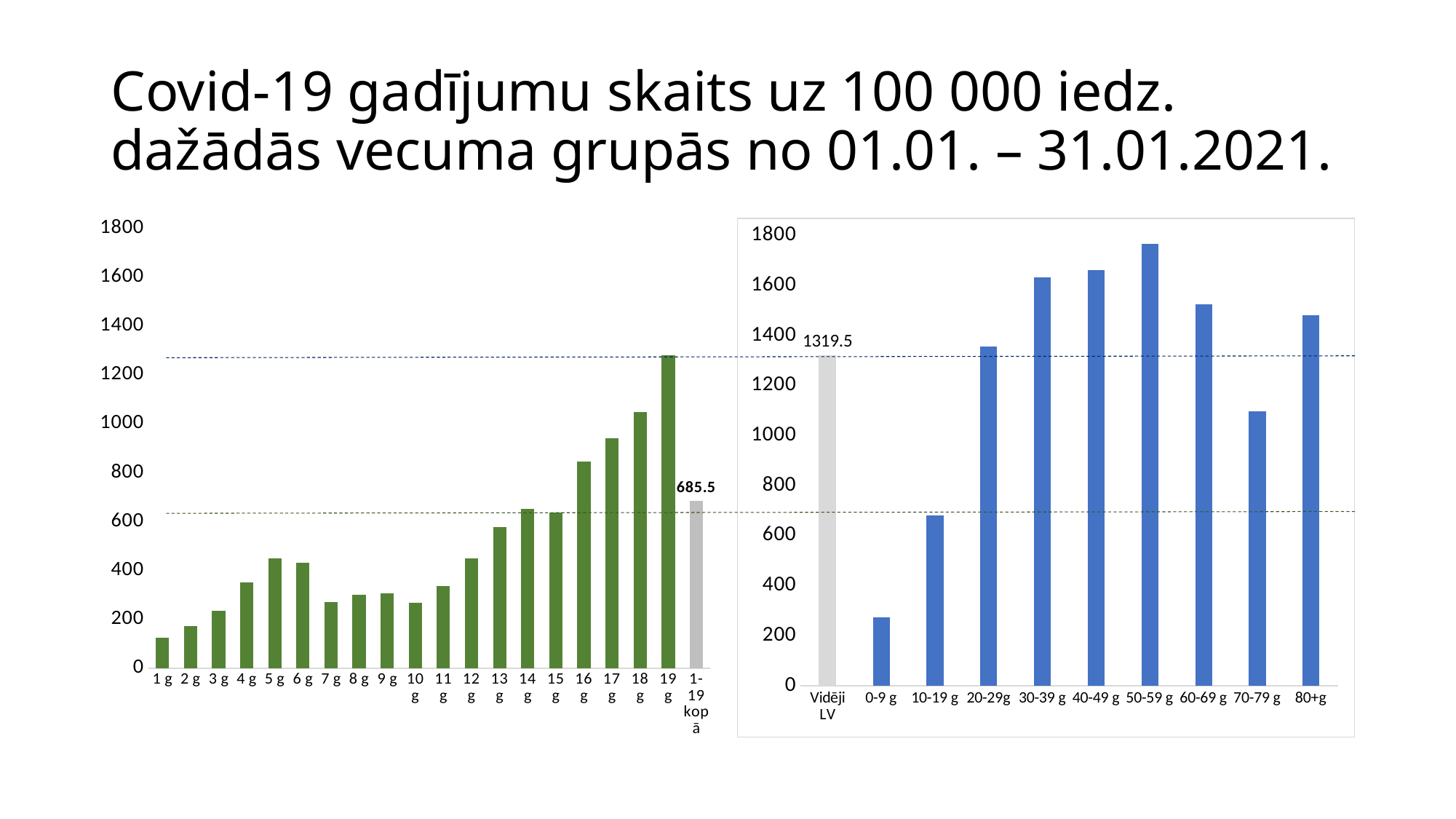
What kind of chart is the left chart? bar chart How many bars are plotted on the left chart? 20 On the left chart, which age category has the highest value? 19 g What is the difference between the "Vidēji LV" value on the right chart and the "1-19 kopā" value on the left chart? 634 On the left chart, which age category has the lowest value? 1 g On the right chart, is the value for 70-79 g greater or less than 1200? less How many bars are plotted on the right chart? 10 On the left chart, which is larger, the value for 16 g or the value for 17 g? 17 g On the left chart, what is the value shown for the "1-19 kopā" bar? 685.5 On the right chart, which age group has the highest value? 50-59 g On the right chart, what is the value shown for "Vidēji LV"? 1319.5 On the right chart, which age group has the lowest value? 0-9 g